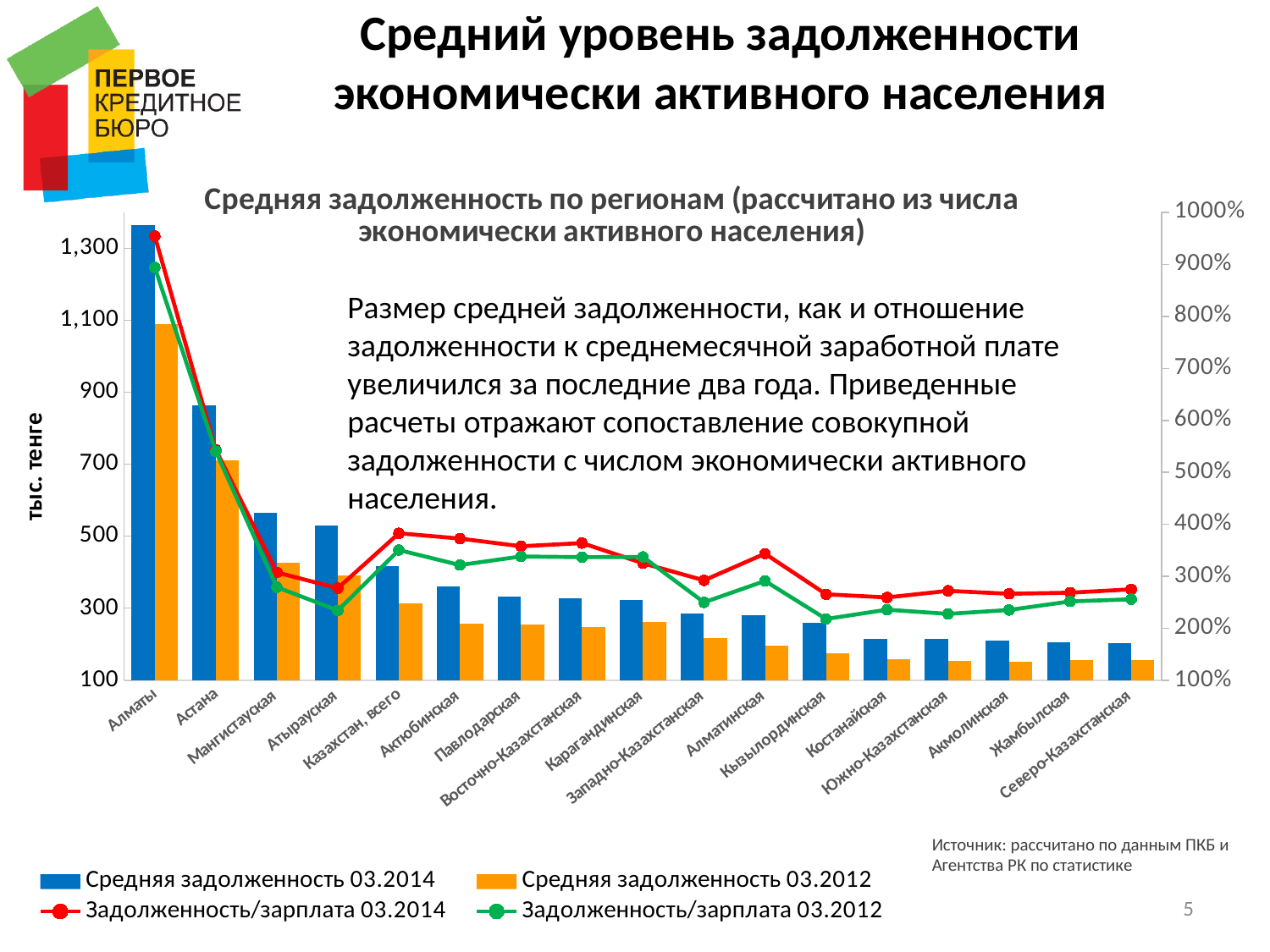
Which region has the highest value for Средняя задолженность 03.2014? Алматы Is the value for Задолженность/зарплата 03.2014 in Алматы greater or less than 900%? greater Do the values for Средняя задолженность 03.2014 generally rise or fall from left to right along the x axis? fall Which is larger: Средняя задолженность 03.2014 in Актюбинская or Средняя задолженность 03.2012 in Актюбинская? Средняя задолженность 03.2014 How many regions (categories) are shown on the x axis of the chart? 17 Is the value for Средняя задолженность 03.2014 in Астана greater or less than 700? greater Is the value for Средняя задолженность 03.2012 in Алматы greater or less than 900? greater What is the title of the chart? Средняя задолженность по регионам (рассчитано из числа экономически активного населения) How many series does the chart legend list? 4 What is the label of the left vertical axis? тыс. тенге What kind of chart is shown on the slide? A combined bar and line chart